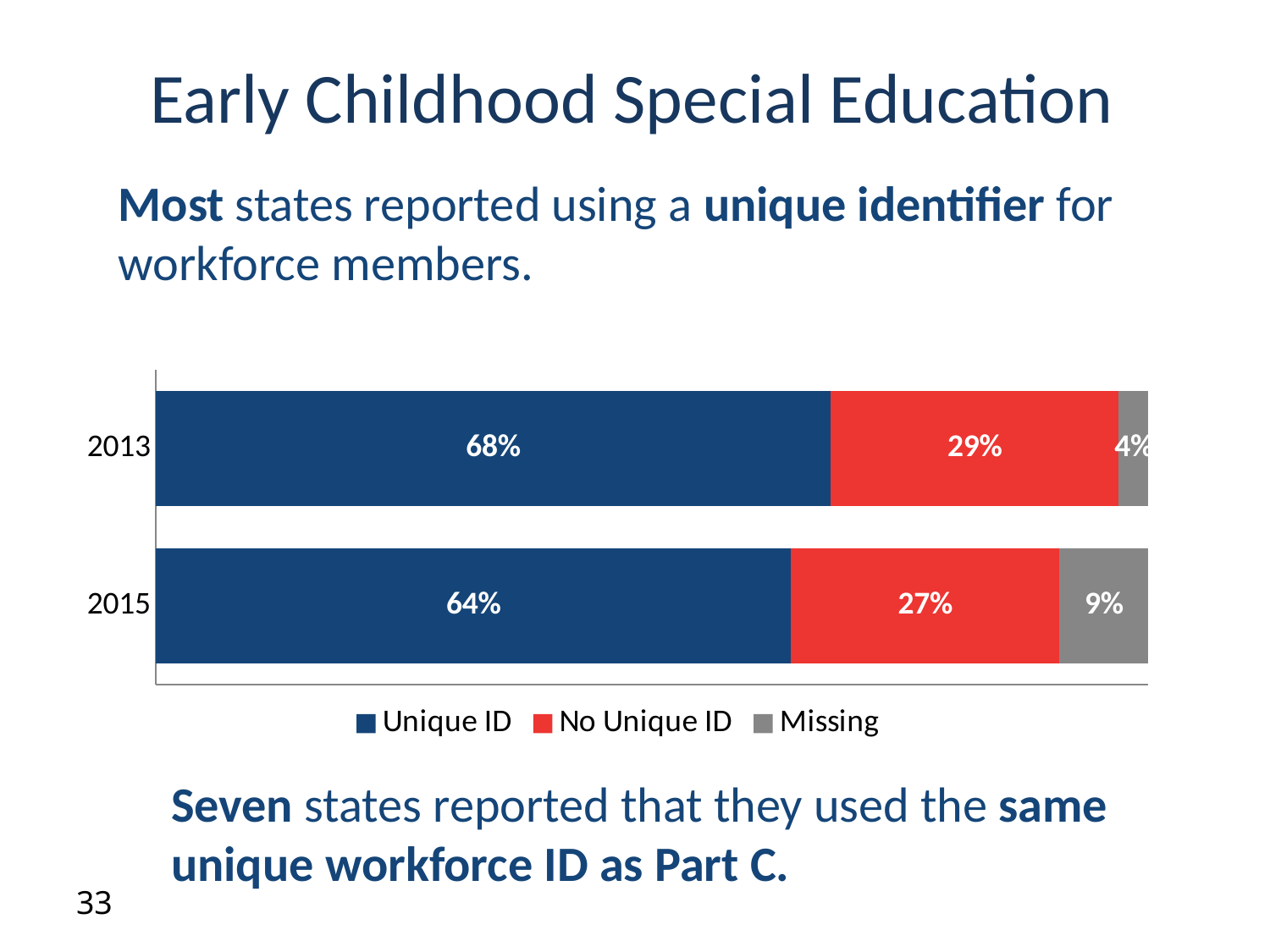
What kind of chart is shown on the slide? Stacked bar chart Which year has the higher Missing percentage? 2015 What is the No Unique ID value for 2015? 27% What percentage of states reported using a Unique ID in 2015? 64% What is the Missing value for 2013? 4% What percentage of states reported using a Unique ID in 2013? 68% What is the difference between the Unique ID percentages for 2013 and 2015? 4 percentage points How many years are shown on the chart? 2 What is the difference between the Missing percentages for 2015 and 2013? 5 percentage points Which year has the higher Unique ID percentage? 2013 How many series does the legend list? 3 Which legend entry is shown in red? No Unique ID